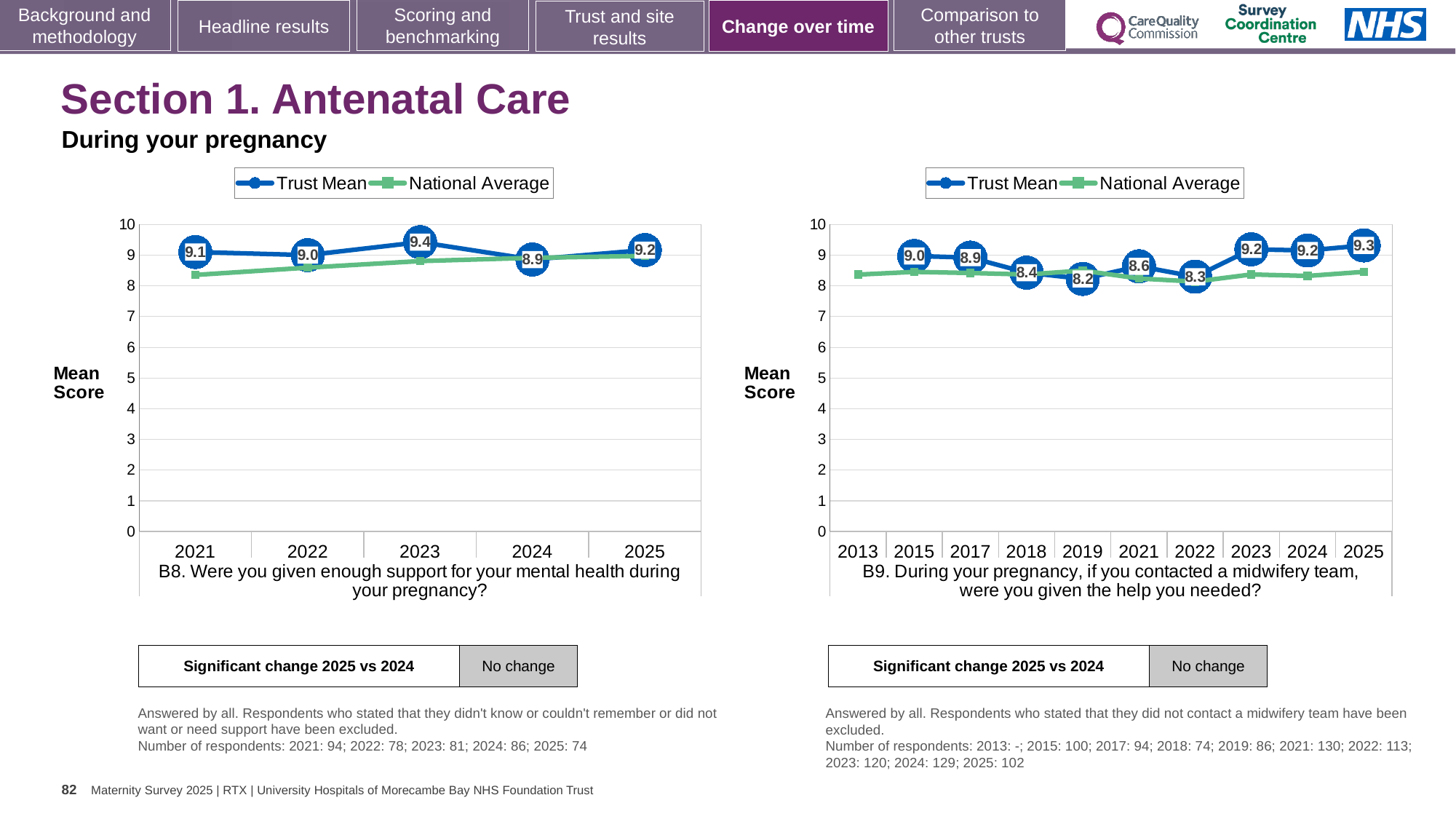
In the B8 chart (left), what is the Trust Mean for 2023? 9.4 In the B8 chart (left), which year has the lowest Trust Mean? 2024 In the B9 chart (right), how many years are shown on the x axis? 10 In the B9 chart (right), is the Trust Mean for 2018 greater or less than 9? less In the B9 chart (right), which year has the highest Trust Mean? 2025 What type of chart is the B8 chart (left)? Line chart In the B9 chart (right), what is the Trust Mean for 2025? 9.3 In the B9 chart (right), what is the difference between the Trust Mean in 2025 and in 2022? 1.0 In the B9 chart (right), what is the Trust Mean for 2019? 8.2 In the B8 chart (left), how many series does the legend list? 2 In the B8 chart (left), what is the difference between the Trust Mean in 2023 and in 2024? 0.5 In the B8 chart (left), what is the Trust Mean for 2025? 9.2